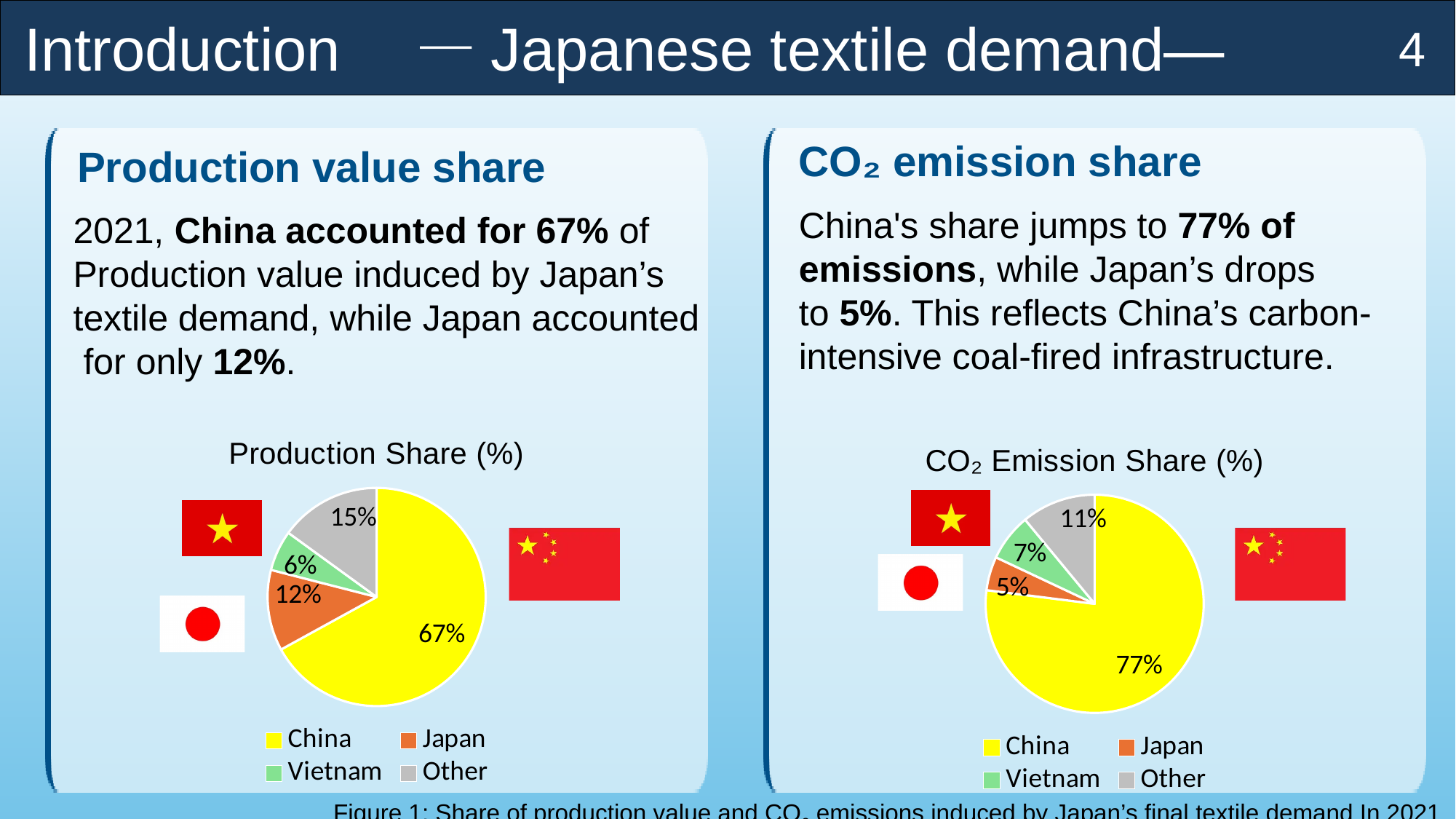
What type of chart is the CO₂ Emission Share (%) chart? Pie chart In the Production Share (%) pie chart, what is the value for China? 67% How many entries does the legend of the CO₂ Emission Share (%) chart list? 4 In the Production Share (%) pie chart, what colour represents China? Yellow In the Production Share (%) pie chart, what is the value for Japan? 12% In the CO₂ Emission Share (%) pie chart, which category has the largest slice? China How many slices does the Production Share (%) pie chart have? 4 In the CO₂ Emission Share (%) pie chart, what is the value for Vietnam? 7% In the CO₂ Emission Share (%) pie chart, what is the value for Other? 11% In the Production Share (%) pie chart, which is larger, the slice for Other or the slice for Japan? Other In the Production Share (%) pie chart, which category has the smallest slice? Vietnam In the CO₂ Emission Share (%) pie chart, what is the difference between China's and Japan's shares? 72%